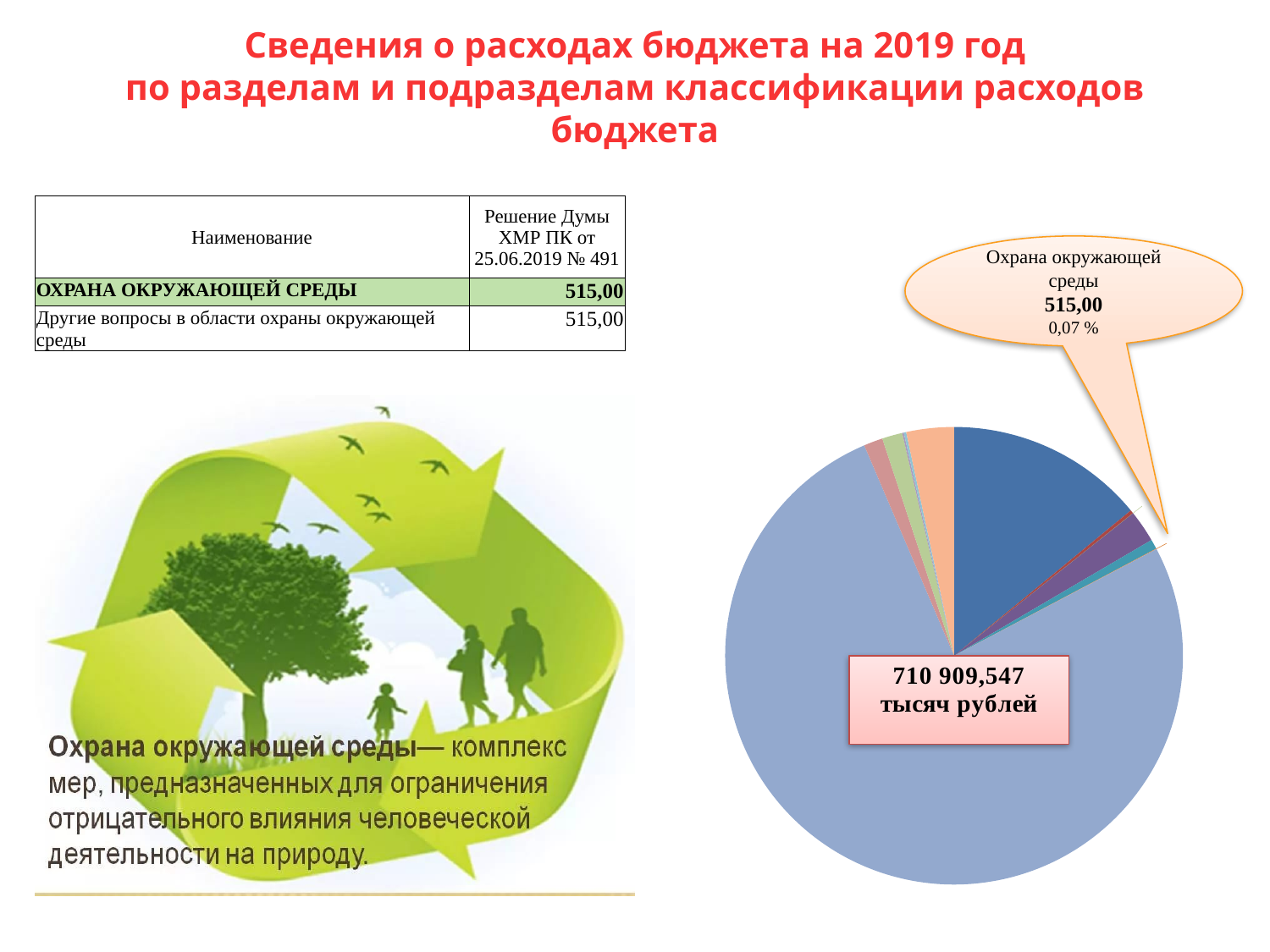
What share of the pie does the Охрана окружающей среды slice represent, according to the callout? 0,07 % According to the callout on the pie chart, what is the value for Охрана окружающей среды? 515,00 What total amount is printed in the box on the pie chart? 710 909,547 тысяч рублей What kind of chart is shown on the right side of the slide? pie chart Does the pie chart have a legend listing its categories? No Which category is named in the callout pointing to a slice of the pie chart? Охрана окружающей среды